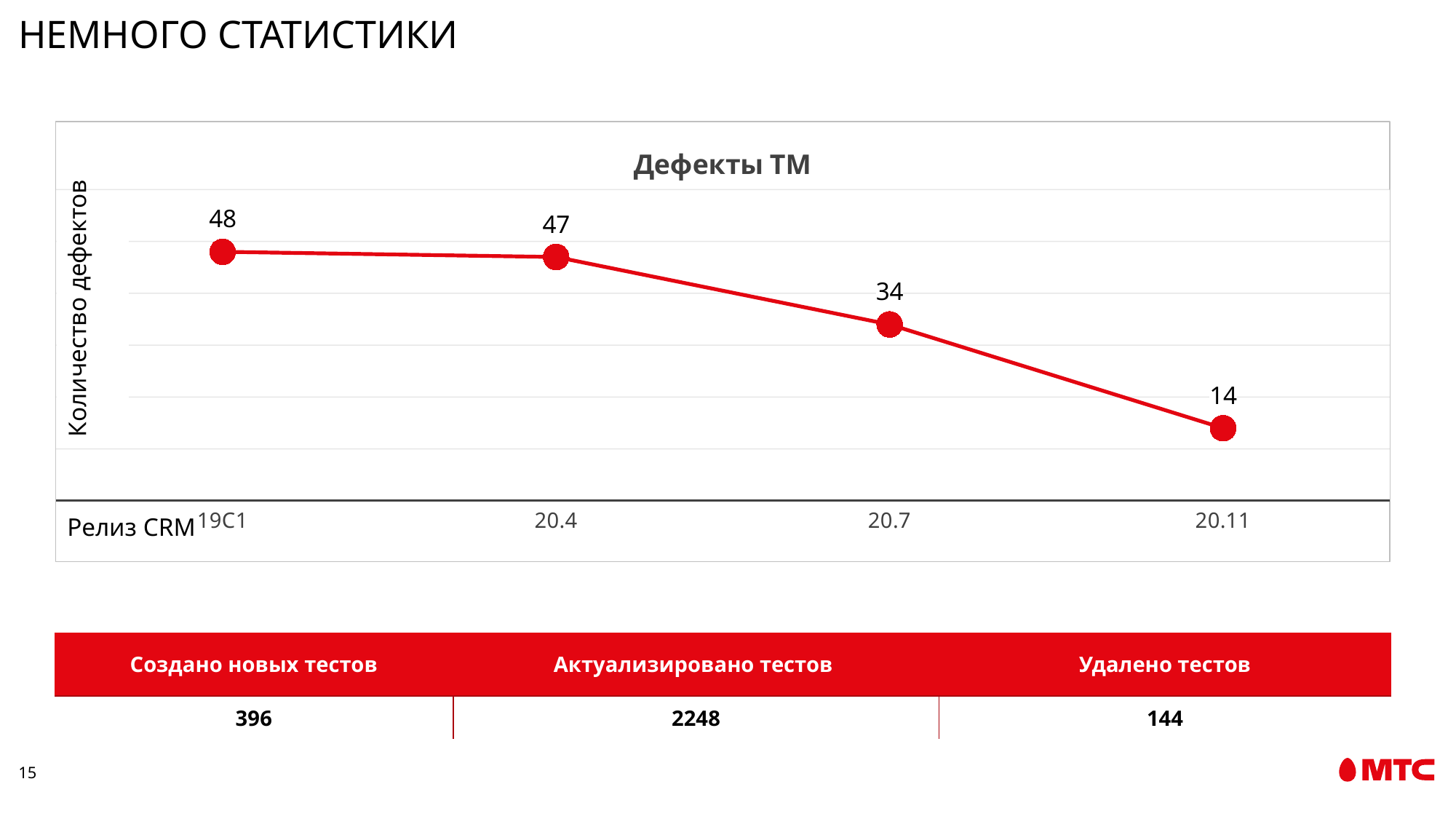
What is the number of defects for release 20.4? 47 Do the defect counts rise or fall across the releases from 19C1 to 20.11? Fall What is the number of defects for release 20.11? 14 Which release has the lowest number of defects? 20.11 Which release has the highest number of defects? 19C1 What is the difference in defects between release 20.7 and release 20.11? 20 What is the number of defects for release 19C1? 48 What is the difference in defects between release 19C1 and release 20.11? 34 Which release has more defects, 20.4 or 20.7? 20.4 What type of chart is shown on the slide? Line chart How many releases are plotted on the chart? 4 What is the number of defects for release 20.7? 34